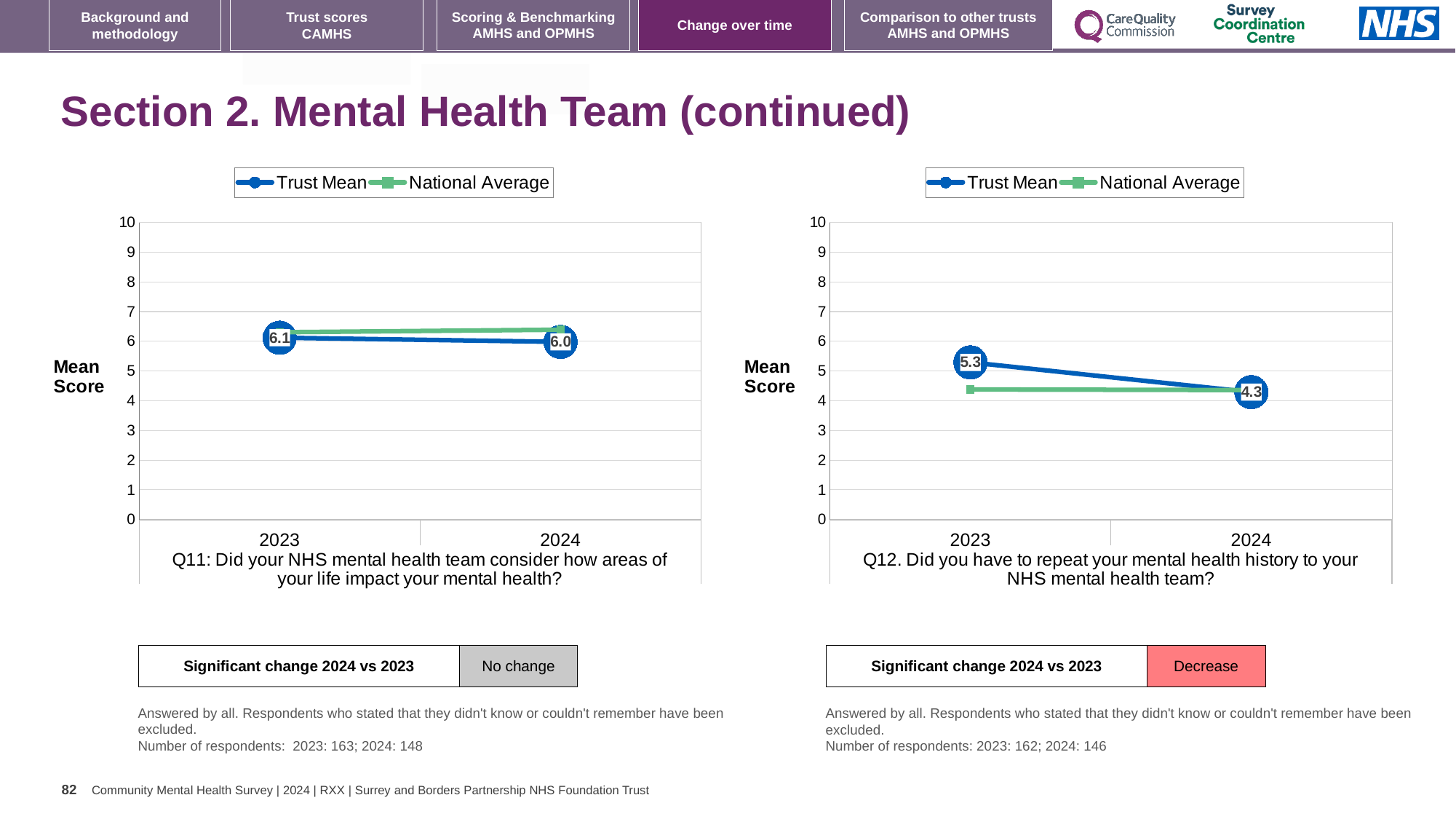
In the Q12 chart (right), is the National Average value for 2023 greater or less than 4? greater In the Q12 chart (right), which year has the higher Trust Mean, 2023 or 2024? 2023 In the Q11 chart (left), what is the Trust Mean score for 2023? 6.1 How many series does the legend of the Q11 chart (left) list? 2 In the Q12 chart (right), by how much did the Trust Mean fall from 2023 to 2024? 1.0 In the Q12 chart (right), what is the Trust Mean score for 2023? 5.3 In the Q11 chart (left), what is the Trust Mean score for 2024? 6.0 In the Q11 chart (left), is the National Average value for 2024 greater or less than 7? less In the Q12 chart (right), what is the Trust Mean score for 2024? 4.3 What kind of chart is the Q12 chart (right)? Line chart In the Q11 chart (left), what is the difference between the Trust Mean in 2023 and in 2024? 0.1 In the Q12 chart (right), does the Trust Mean rise or fall from 2023 to 2024? Fall